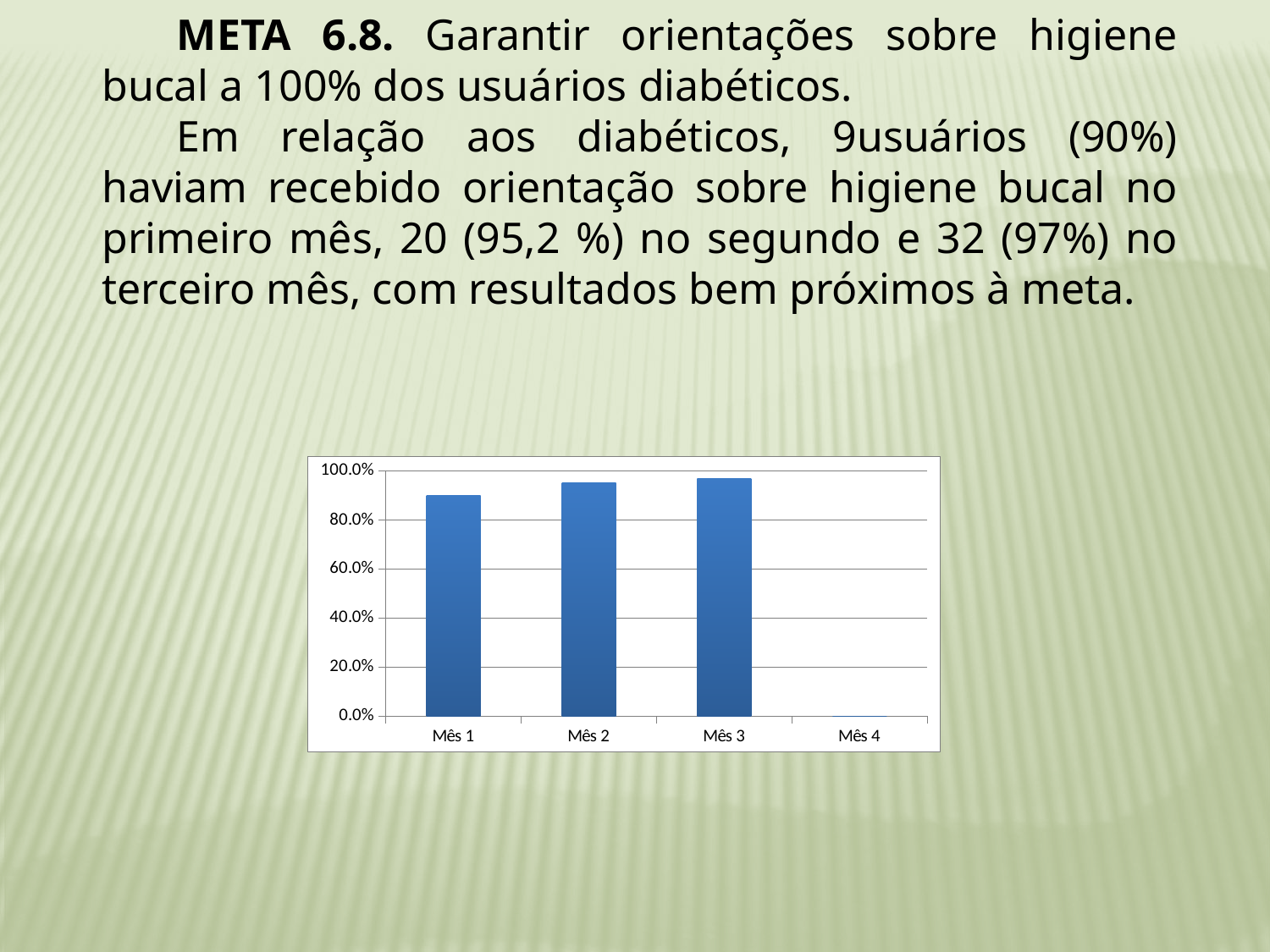
What is the highest tick value shown on the y axis of the chart? 100.0% Do the values rise or fall from Mês 1 to Mês 3? rise Is the value for Mês 3 greater or less than 100.0%? less Which is larger, the value for Mês 1 or the value for Mês 4? Mês 1 How many categories are shown on the x axis of the chart? 4 What is the label of the first category on the x axis? Mês 1 Is the value for Mês 2 greater or less than 80.0%? greater Is the value for Mês 1 greater or less than 100.0%? less What kind of chart is shown on the slide? bar chart Which category has the lowest value in the chart? Mês 4